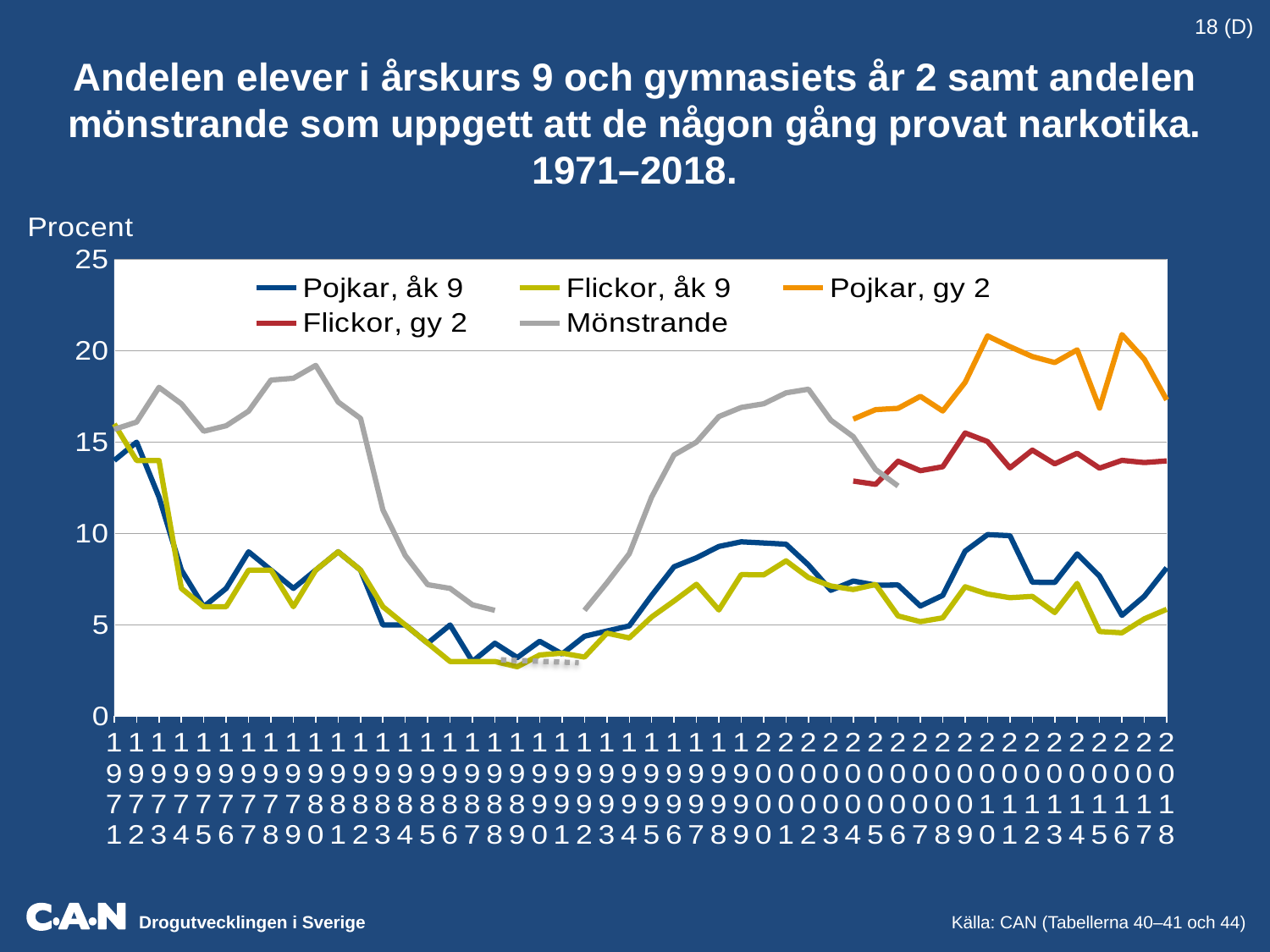
What is the label on the vertical axis? Procent In 2018, which is higher: Pojkar, åk 9 or Flickor, åk 9? Pojkar, åk 9 Is the value for Mönstrande in 1983 greater or less than 15? less What kind of chart is shown on the slide? Line chart Which series has the highest value in 2018? Pojkar, gy 2 In 2018, which is higher: Pojkar, gy 2 or Flickor, gy 2? Pojkar, gy 2 How many series does the legend list? 5 Is the value for Flickor, gy 2 in 2018 greater or less than 15? less Which colour is used for the Mönstrande series? Grey Is the value for Pojkar, åk 9 in 1990 greater or less than 5? less Does the Pojkar, åk 9 series rise or fall from 1971 to 1990? Fall